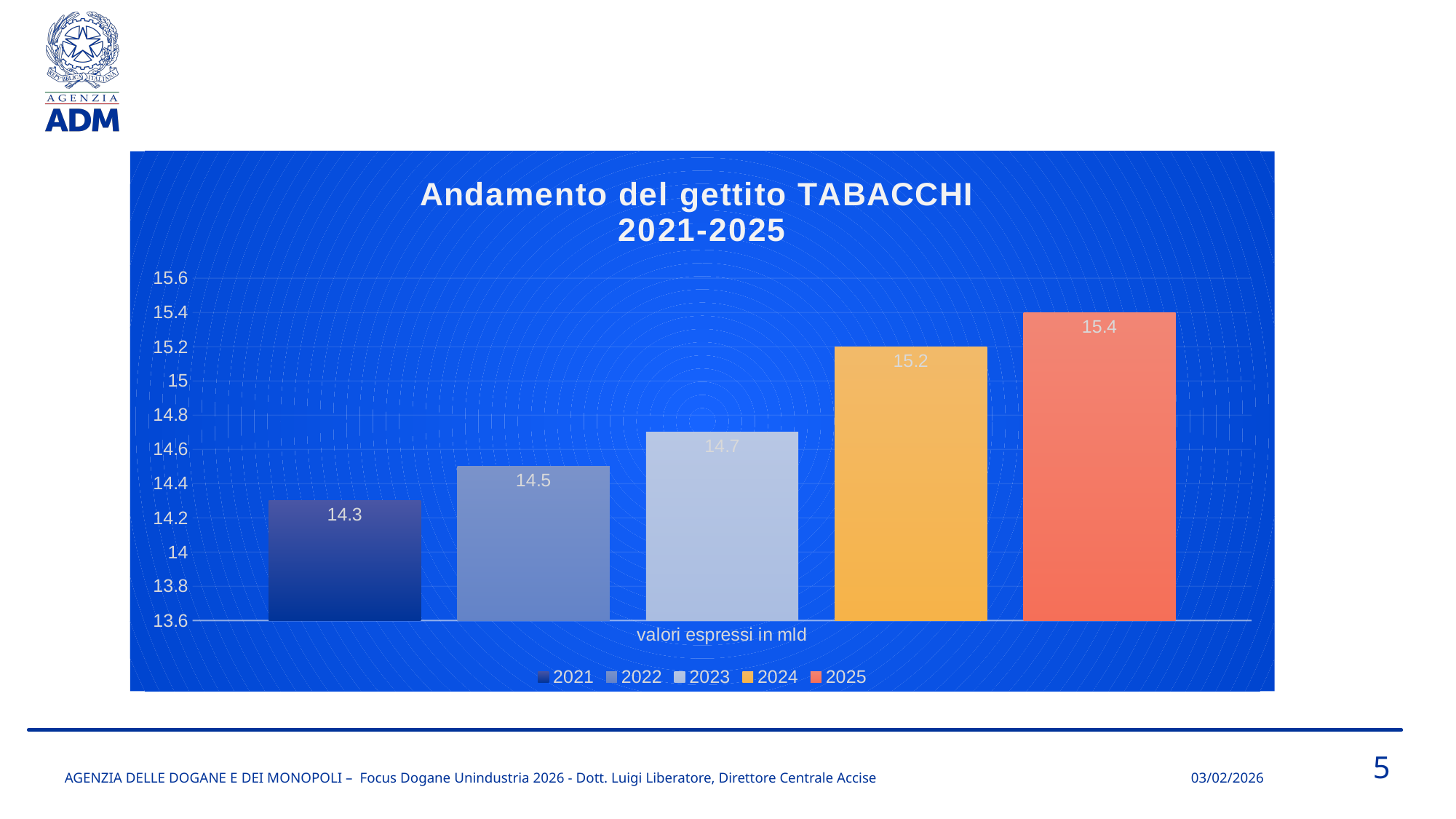
What is the difference between the values for 2024 and 2023? 0.5 Do the values rise or fall from 2021 to 2025? rise What is the value for 2023? 14.7 What is the difference between the values for 2025 and 2021? 1.1 Which year has the highest value? 2025 What is the value for 2021? 14.3 Which year has the lowest value? 2021 Which is larger, the value for 2022 or the value for 2024? 2024 What kind of chart is shown on the slide? bar chart Is the value for 2023 greater or less than 15? less What is the value for 2025? 15.4 How many bars are shown in the chart? 5